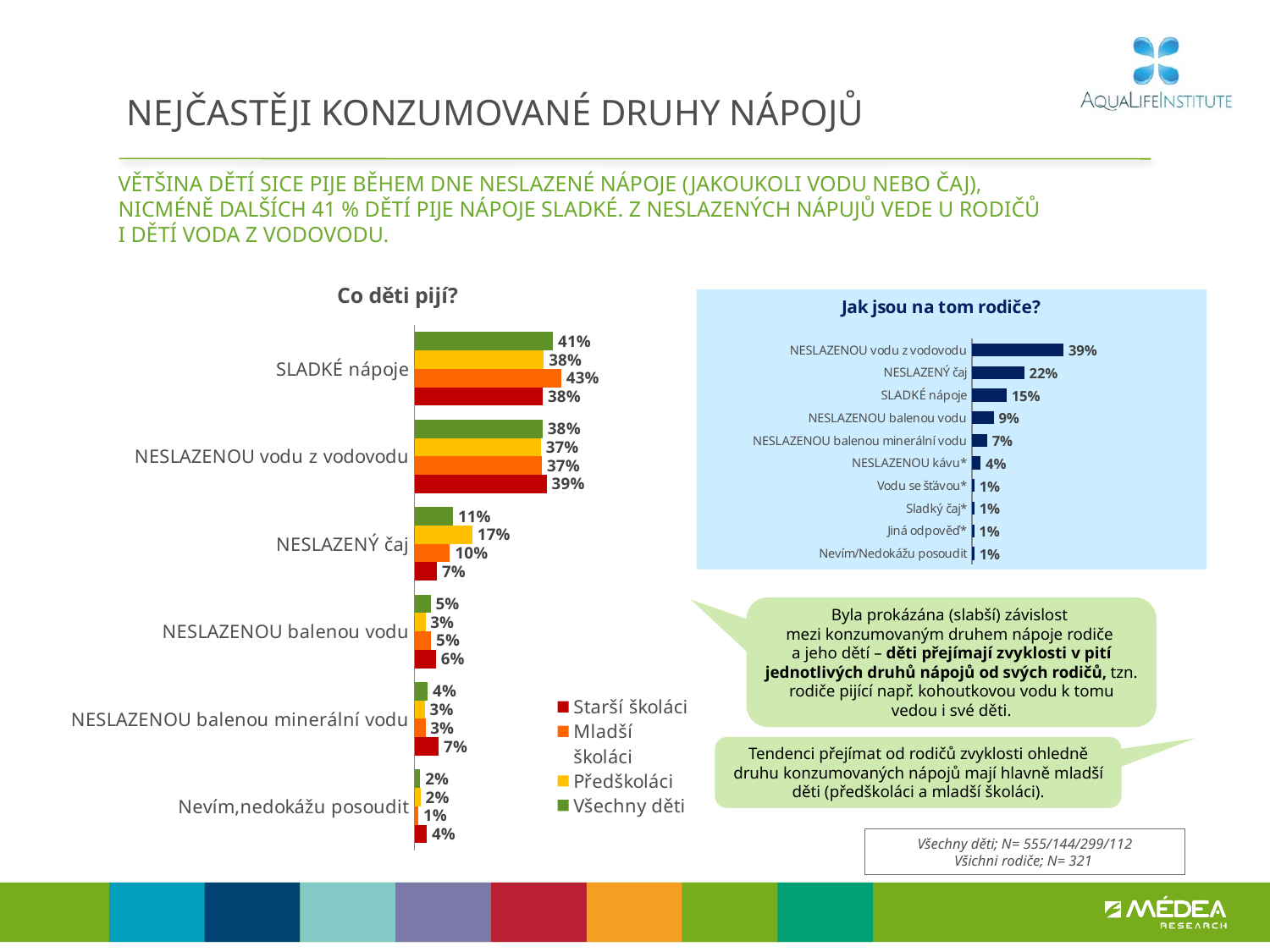
In the chart "Co děti pijí?", what is the difference between Předškoláci and Starší školáci in the NESLAZENÝ čaj category? 10% In the chart "Jak jsou na tom rodiče?", how many categories are shown? 10 In the chart "Co děti pijí?", which colour represents Všechny děti? Green In the chart "Co děti pijí?", which is larger for Starší školáci: NESLAZENÝ čaj or NESLAZENOU balenou minerální vodu? Neither; both are 7% In the chart "Jak jsou na tom rodiče?", what is the value for NESLAZENÝ čaj? 22% In the chart "Jak jsou na tom rodiče?", what is the difference between NESLAZENOU vodu z vodovodu and SLADKÉ nápoje? 24% In the chart "Jak jsou na tom rodiče?", which category has the highest value? NESLAZENOU vodu z vodovodu In the chart "Co děti pijí?", what is the value for Mladší školáci in the SLADKÉ nápoje category? 43% In the chart "Co děti pijí?", how many categories are shown? 6 In the chart "Co děti pijí?", how many series does the legend list? 4 What kind of chart is "Co děti pijí?"? Bar chart In the chart "Co děti pijí?", what is the value for Předškoláci in the NESLAZENÝ čaj category? 17%